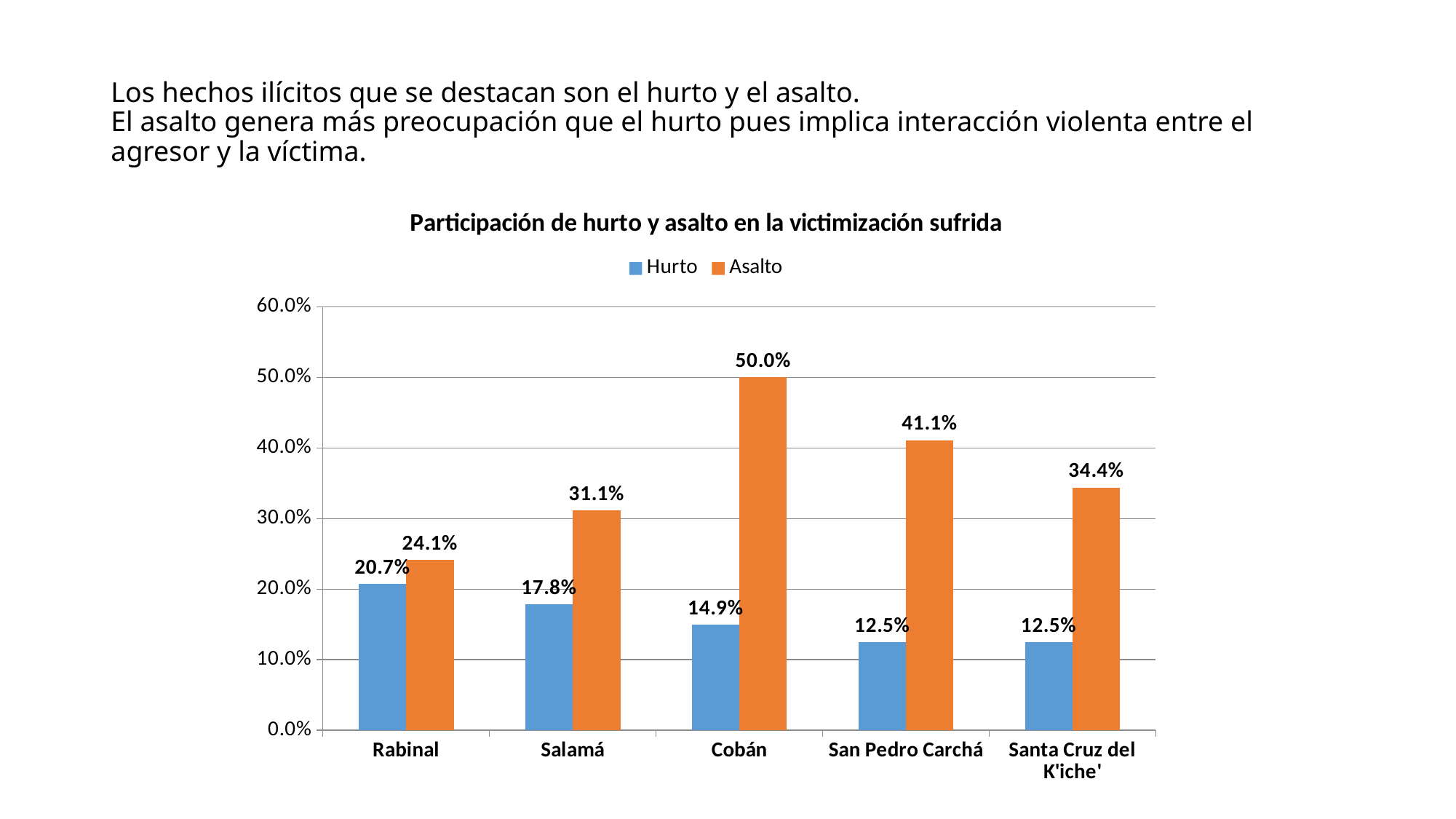
Which category has the lowest Asalto value? Rabinal How many categories are shown on the x axis? 5 Which category has the highest Hurto value? Rabinal What is the difference between the Asalto values for San Pedro Carchá and Salamá? 10.0% What is the difference between the Asalto and Hurto values for Cobán? 35.1% What is the Asalto value for Cobán? 50.0% What kind of chart is shown on the slide? Bar chart What is the Hurto value for Salamá? 17.8% What is the Asalto value for Santa Cruz del K'iche'? 34.4% Which is larger, the Hurto value for Rabinal or the Hurto value for Cobán? Rabinal Which category has the highest Asalto value? Cobán How many series does the legend list? 2